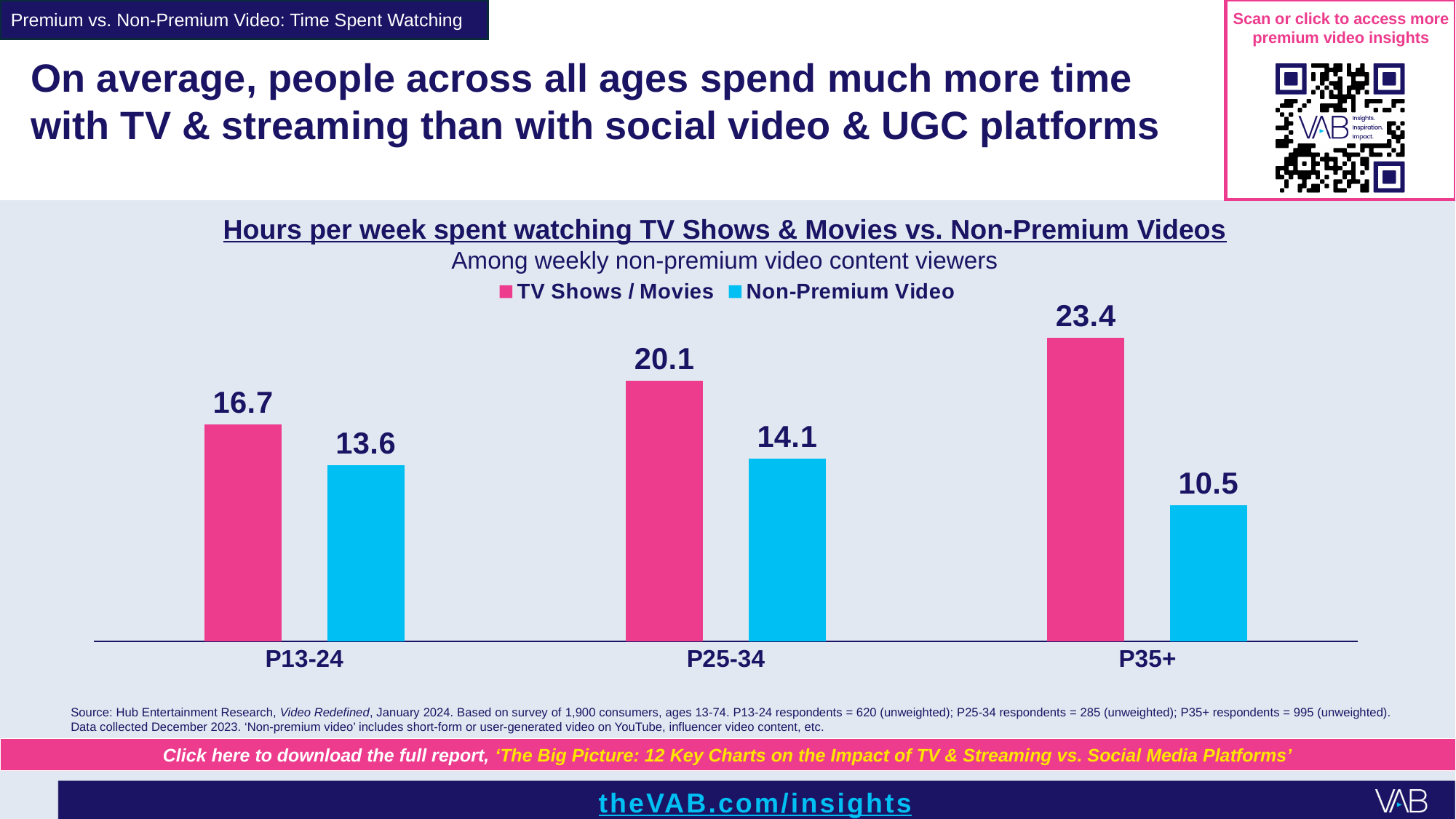
Do the Non-Premium Video values rise or fall from P25-34 to P35+? Fall What is the difference between TV Shows / Movies and Non-Premium Video in the P35+ group? 12.9 Which is larger in the P13-24 group: TV Shows / Movies or Non-Premium Video? TV Shows / Movies What kind of chart is shown on the slide? Bar chart Which age group has the highest value for TV Shows / Movies? P35+ How many age groups are shown on the x axis? 3 What is the value for Non-Premium Video in the P35+ group? 10.5 Which age group has the lowest value for Non-Premium Video? P35+ What is the value for Non-Premium Video in the P25-34 group? 14.1 How many series does the legend list? 2 What is the value for TV Shows / Movies in the P13-24 group? 16.7 What is the difference between TV Shows / Movies for P25-34 and P13-24? 3.4